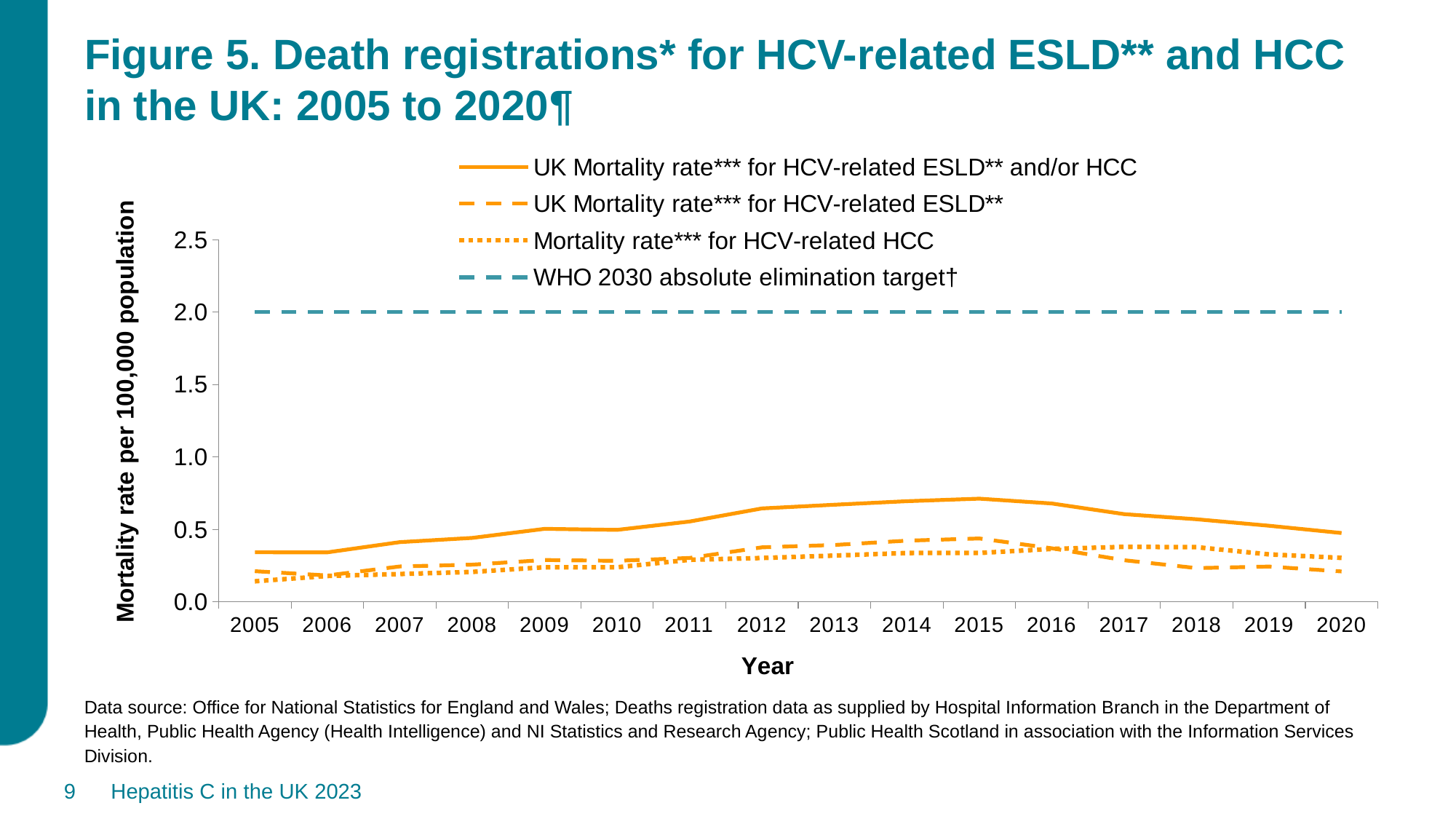
Does the UK Mortality rate for HCV-related ESLD and/or HCC rise or fall between 2005 and 2015? rise Which series is drawn as a dotted line in the legend? Mortality rate*** for HCV-related HCC Is the UK Mortality rate for HCV-related ESLD and/or HCC in 2005 greater or less than 0.5? less What kind of chart is shown on the slide? line chart How many series does the legend list? 4 How many years are plotted along the x axis? 16 Is the UK Mortality rate for HCV-related ESLD and/or HCC in 2015 greater or less than 0.5? greater Is the Mortality rate for HCV-related HCC in 2020 greater or less than 0.5? less In which year does the UK Mortality rate for HCV-related ESLD and/or HCC reach its highest point? 2015 What value does the WHO 2030 absolute elimination target line sit at? 2.0 What is the label of the y axis? Mortality rate per 100,000 population Which is larger in 2020: the UK Mortality rate for HCV-related ESLD or the Mortality rate for HCV-related HCC? Mortality rate for HCV-related HCC